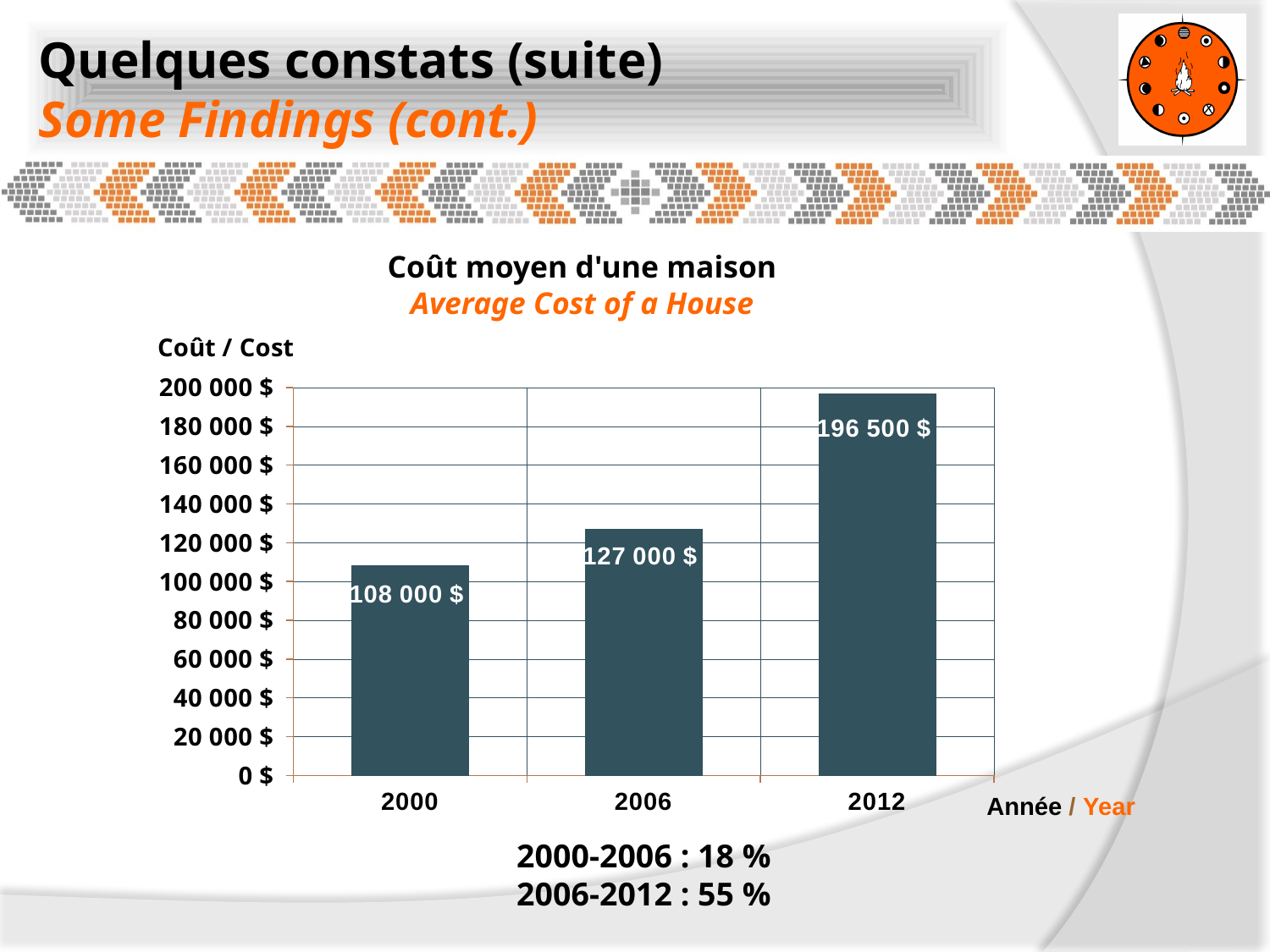
Which year has a higher average cost of a house, 2000 or 2006? 2006 What is the average cost of a house in 2000? 108 000 $ What is the difference between the average cost of a house in 2012 and in 2006? 69 500 $ What is the average cost of a house in 2006? 127 000 $ How many years are shown on the chart? 3 What kind of chart is shown on the slide? Bar chart Which year has the lowest average cost of a house? 2000 Which year has the highest average cost of a house? 2012 Does the average cost of a house rise or fall from 2000 to 2012? Rise What is the difference between the average cost of a house in 2006 and in 2000? 19 000 $ Is the average cost of a house in 2012 greater or less than 180 000 $? greater What is the average cost of a house in 2012? 196 500 $